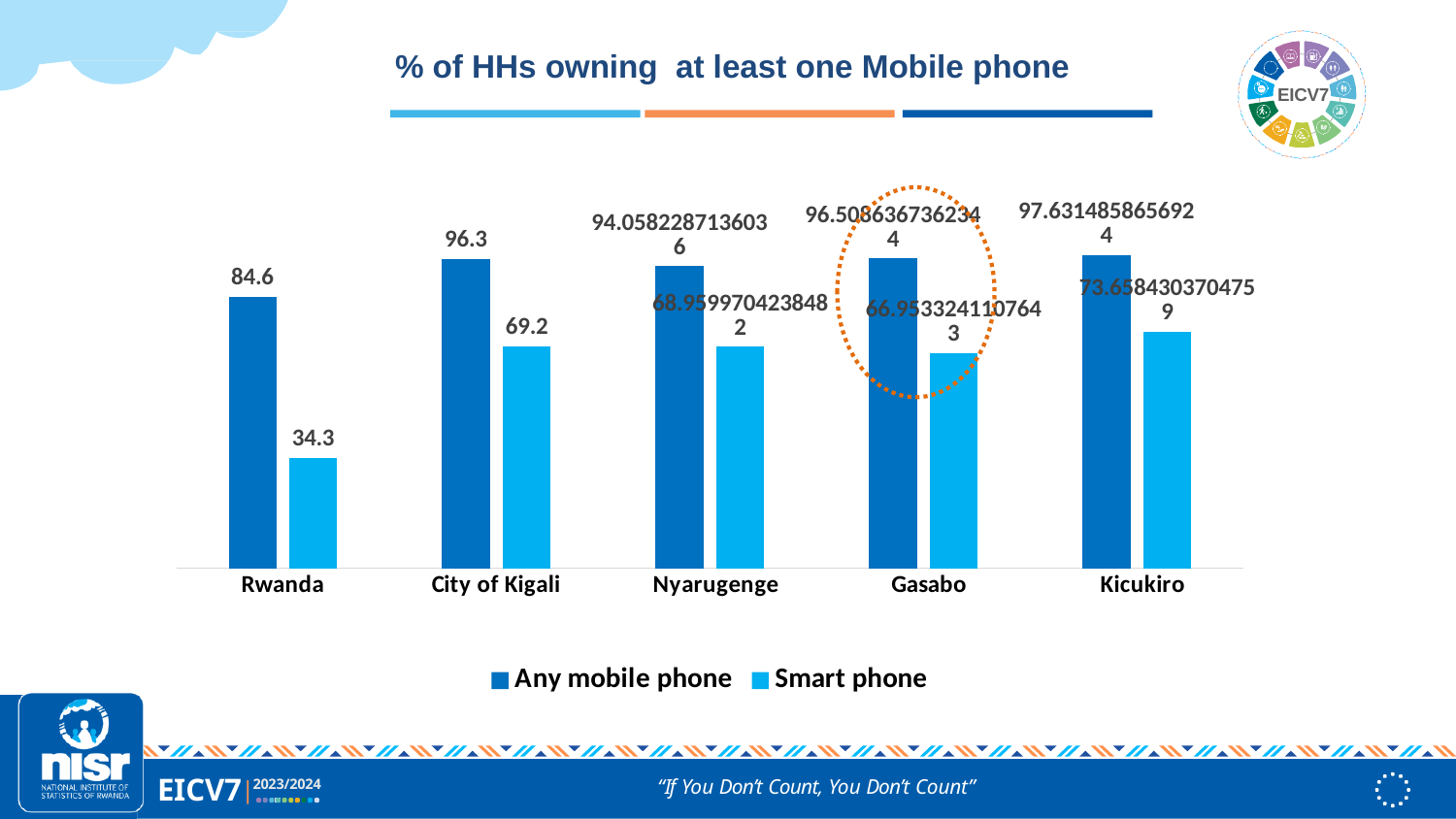
Which category has the lowest Smart phone value? Rwanda What is the value for Smart phone in Rwanda? 34.3 What is the value for Smart phone in City of Kigali? 69.2 Which category has the highest Smart phone value? Kicukiro How many categories are shown on the x axis? 5 What is the value for Any mobile phone in Rwanda? 84.6 Which category has the lowest Any mobile phone value? Rwanda Which is larger: the Smart phone value for City of Kigali or for Rwanda? City of Kigali What is the value for Any mobile phone in City of Kigali? 96.3 How many series does the legend list? 2 What kind of chart is shown on the slide? Bar chart What is the difference between the Any mobile phone and Smart phone values for Rwanda? 50.3